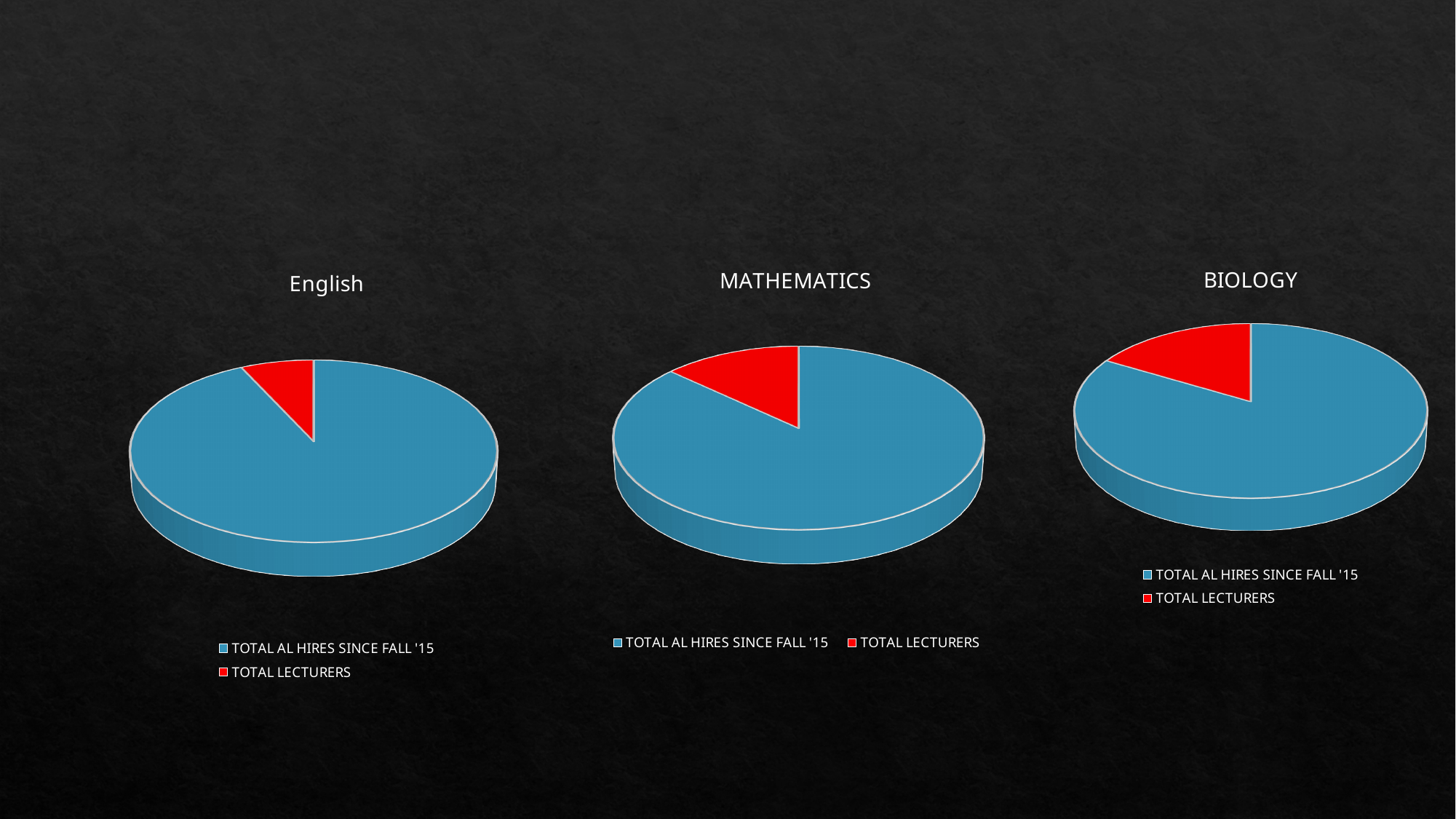
How many pie charts are shown on the slide? 3 In the MATHEMATICS chart, which category has the largest slice? TOTAL AL HIRES SINCE FALL '15 What kind of chart is the MATHEMATICS chart? pie chart In the English chart, which category has the smallest slice? TOTAL LECTURERS In the BIOLOGY chart, which category has the smallest slice? TOTAL LECTURERS What is the title of the chart on the right of the slide? BIOLOGY How many entries does the legend of the BIOLOGY chart list? 2 What colour represents TOTAL LECTURERS in the MATHEMATICS chart? red In the English chart, which category has the largest slice? TOTAL AL HIRES SINCE FALL '15 How many entries does the legend of the English chart list? 2 What kind of chart is the English chart? pie chart In the BIOLOGY chart, which slice is larger, TOTAL AL HIRES SINCE FALL '15 or TOTAL LECTURERS? TOTAL AL HIRES SINCE FALL '15